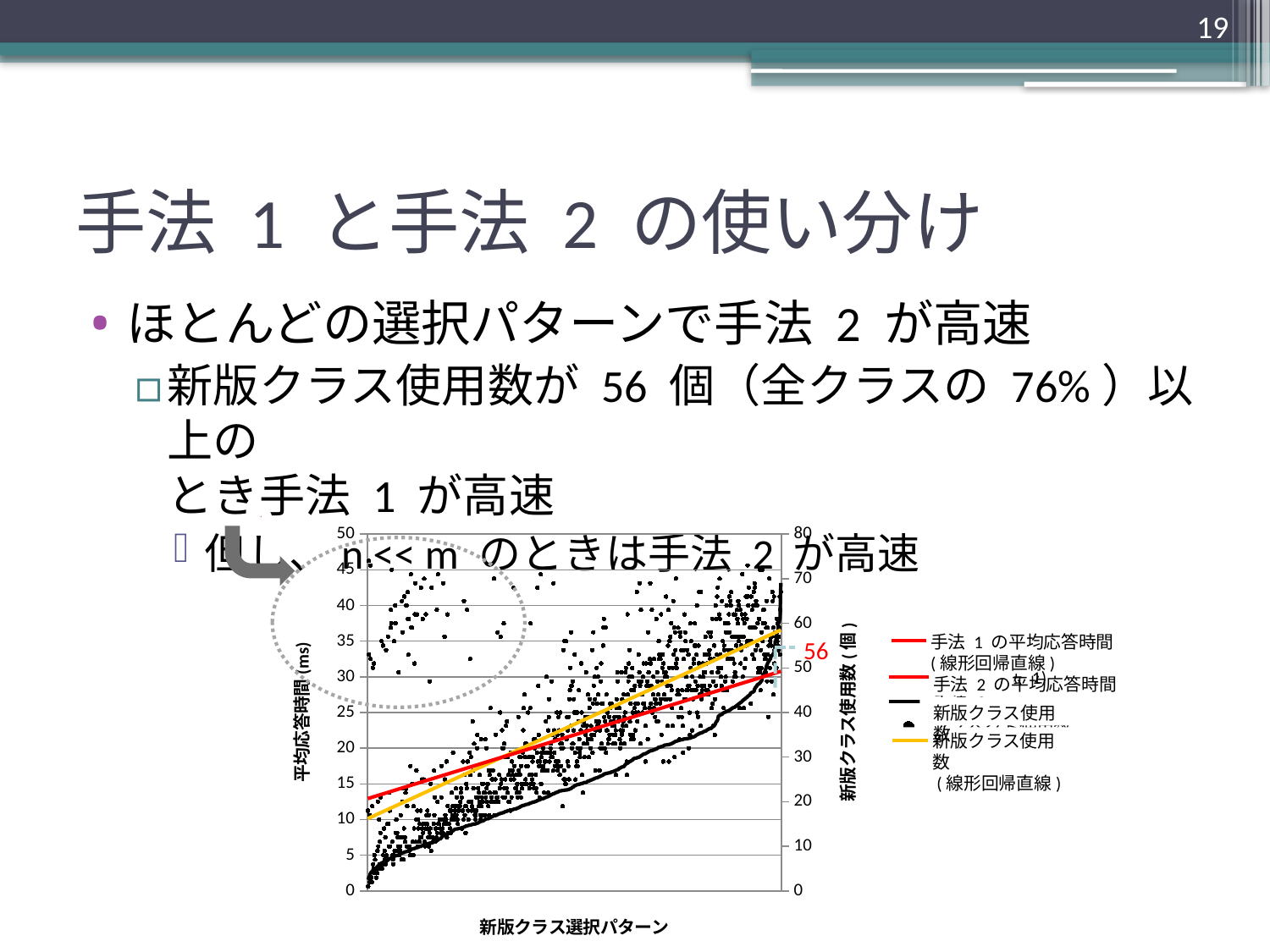
What is the maximum value shown on the right vertical axis of the chart? 80 What is the maximum value shown on the left vertical axis of the chart? 50 What value is annotated in red on the right axis of the chart? 56 At the right end of the chart, is the black 新版クラス使用数 line greater or less than 60 on the right axis? greater At the left end of the chart, is the red 手法 1 regression line greater or less than 10 on the left axis? greater What is the label of the left vertical axis of the chart? 平均応答時間 (ms) What is the label of the right vertical axis of the chart? 新版クラス使用数 (個) Does the black line for 新版クラス使用数 rise or fall from left to right along the x axis? rise At the right end of the chart, which regression line is higher: the yellow 新版クラス使用数 line or the red 手法 1 line? the yellow 新版クラス使用数 line What kind of chart is shown on the slide? scatter chart